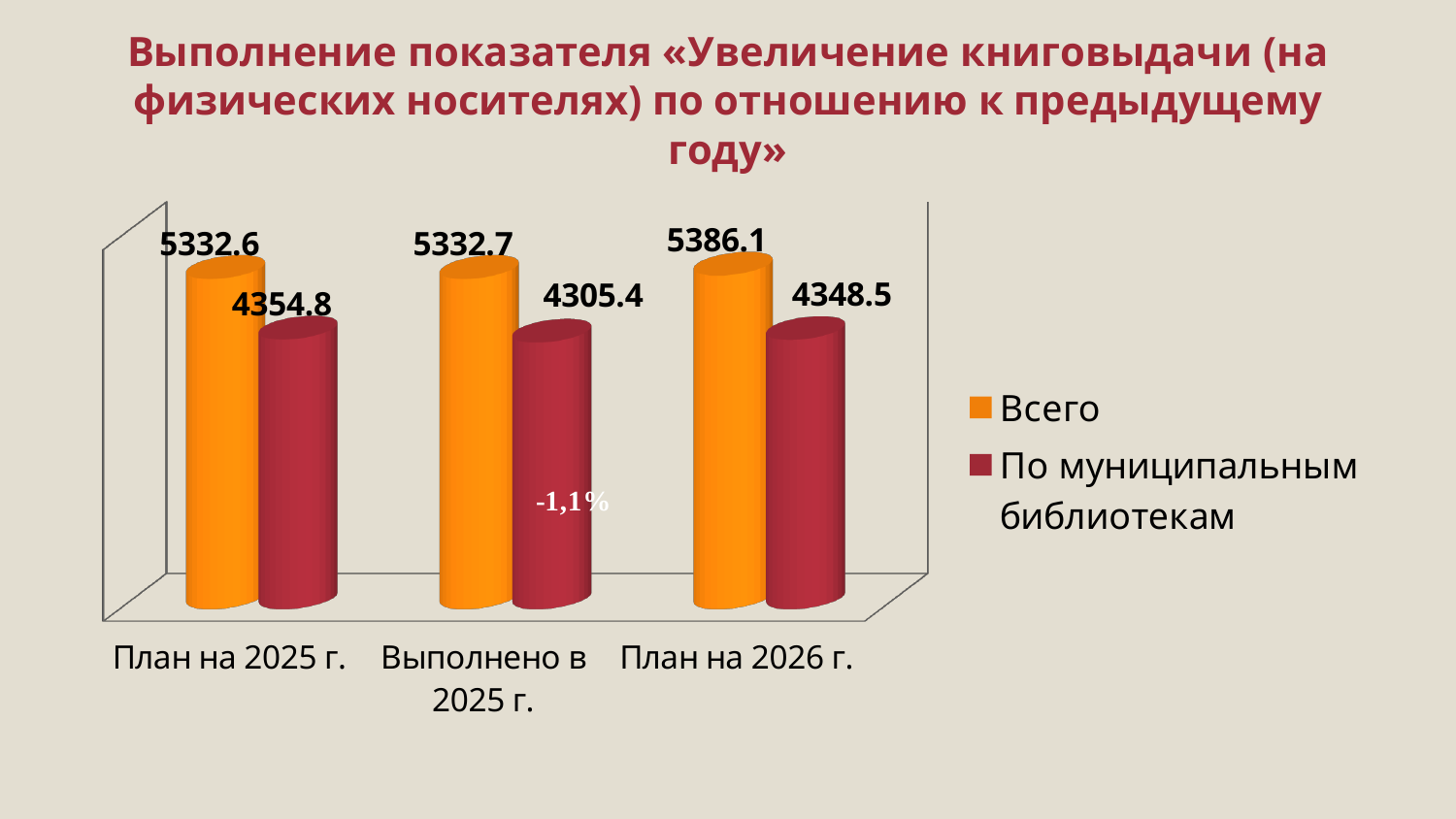
In which category is the «По муниципальным библиотекам» value the lowest? Выполнено в 2025 г. Which is larger: the «По муниципальным библиотекам» value for «План на 2025 г.» or for «Выполнено в 2025 г.»? План на 2025 г. How many categories are shown on the x axis of the chart? 3 How many series does the legend list? 2 What is the value for «Всего» in the category «План на 2026 г.»? 5386.1 What is the value for «По муниципальным библиотекам» in the category «План на 2026 г.»? 4348.5 What is the difference between the «Всего» and «По муниципальным библиотекам» values for «План на 2025 г.»? 977.8 What is the value for «По муниципальным библиотекам» in the category «Выполнено в 2025 г.»? 4305.4 By how much does the «Всего» value for «План на 2026 г.» exceed the «Всего» value for «Выполнено в 2025 г.»? 53.4 In which category is the «Всего» value the highest? План на 2026 г. What kind of chart is shown on the slide? Bar chart What is the value for «Всего» in the category «План на 2025 г.»? 5332.6